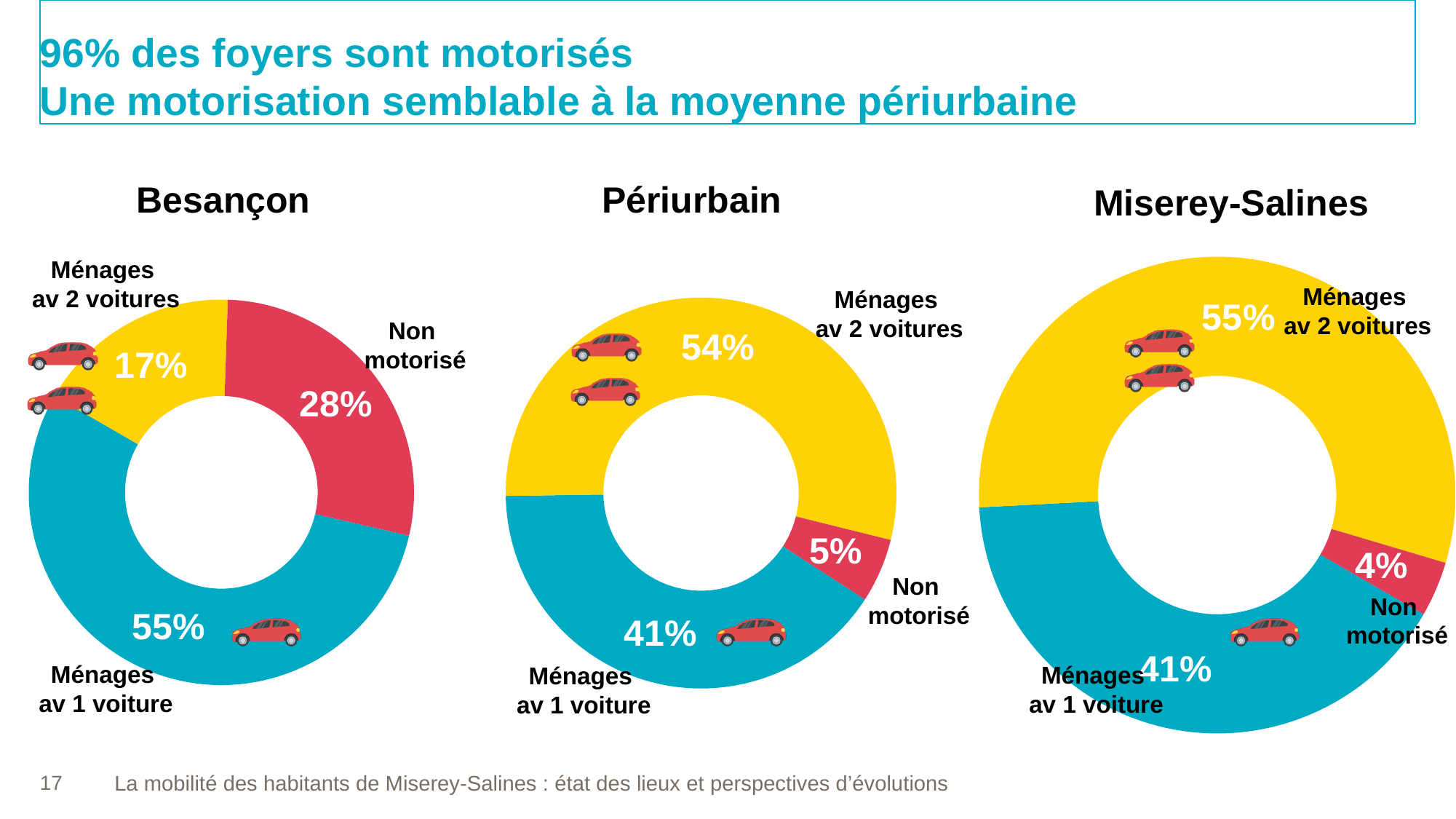
In the Besançon chart, what share of households has 2 cars (Ménages av 2 voitures)? 17% In the Miserey-Salines chart, which category has the largest share? Ménages av 2 voitures In the Besançon chart, what share of households is non-motorised (Non motorisé)? 28% What type of chart is used for Périurbain? Donut (pie) chart How many categories does the Miserey-Salines chart show? 3 Which is larger: the non-motorised share in Besançon or the non-motorised share in Miserey-Salines? Besançon How many charts are shown on the slide? 3 In the Périurbain chart, what share of households has 1 car (Ménages av 1 voiture)? 41% In the Miserey-Salines chart, what share of households is non-motorised (Non motorisé)? 4% In the Besançon chart, which category has the smallest share? Ménages av 2 voitures In the Périurbain chart, which category has the smallest share? Non motorisé In the Périurbain chart, what is the difference between the share of households with 2 cars and the share with 1 car? 13 percentage points